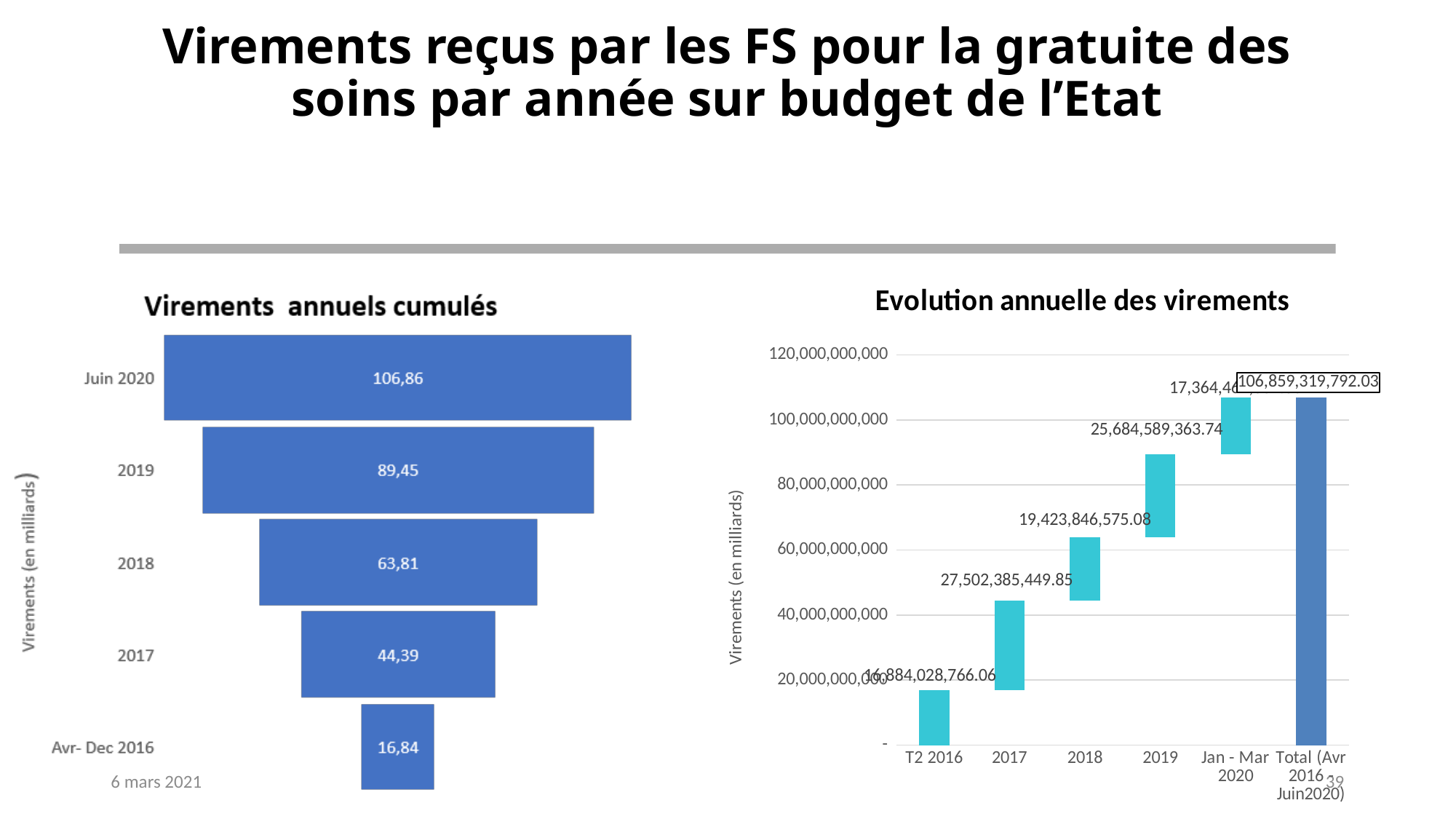
In the 'Evolution annuelle des virements' chart, what is the value for Total (Avr 2016 Juin2020)? 106,859,319,792.03 In the 'Evolution annuelle des virements' chart, what is the value for 2019? 25,684,589,363.74 What is the y-axis label of the 'Evolution annuelle des virements' chart? Virements (en milliards) In the 'Virements annuels cumulés' chart, what is the value for 2018? 63,81 In the 'Evolution annuelle des virements' chart, how many categories are on the x axis? 6 In the 'Virements annuels cumulés' chart, what is the difference between the values for 2019 and 2017? 45,06 In the 'Virements annuels cumulés' chart, what is the value for Avr- Dec 2016? 16,84 In the 'Evolution annuelle des virements' chart, what is the value for 2017? 27,502,385,449.85 In the 'Evolution annuelle des virements' chart, which is larger, the value for 2017 or the value for 2018? 2017 In the 'Virements annuels cumulés' chart, how many categories are shown? 5 In the 'Virements annuels cumulés' chart, what is the value for Juin 2020? 106,86 In the 'Virements annuels cumulés' chart, which category has the lowest value? Avr- Dec 2016